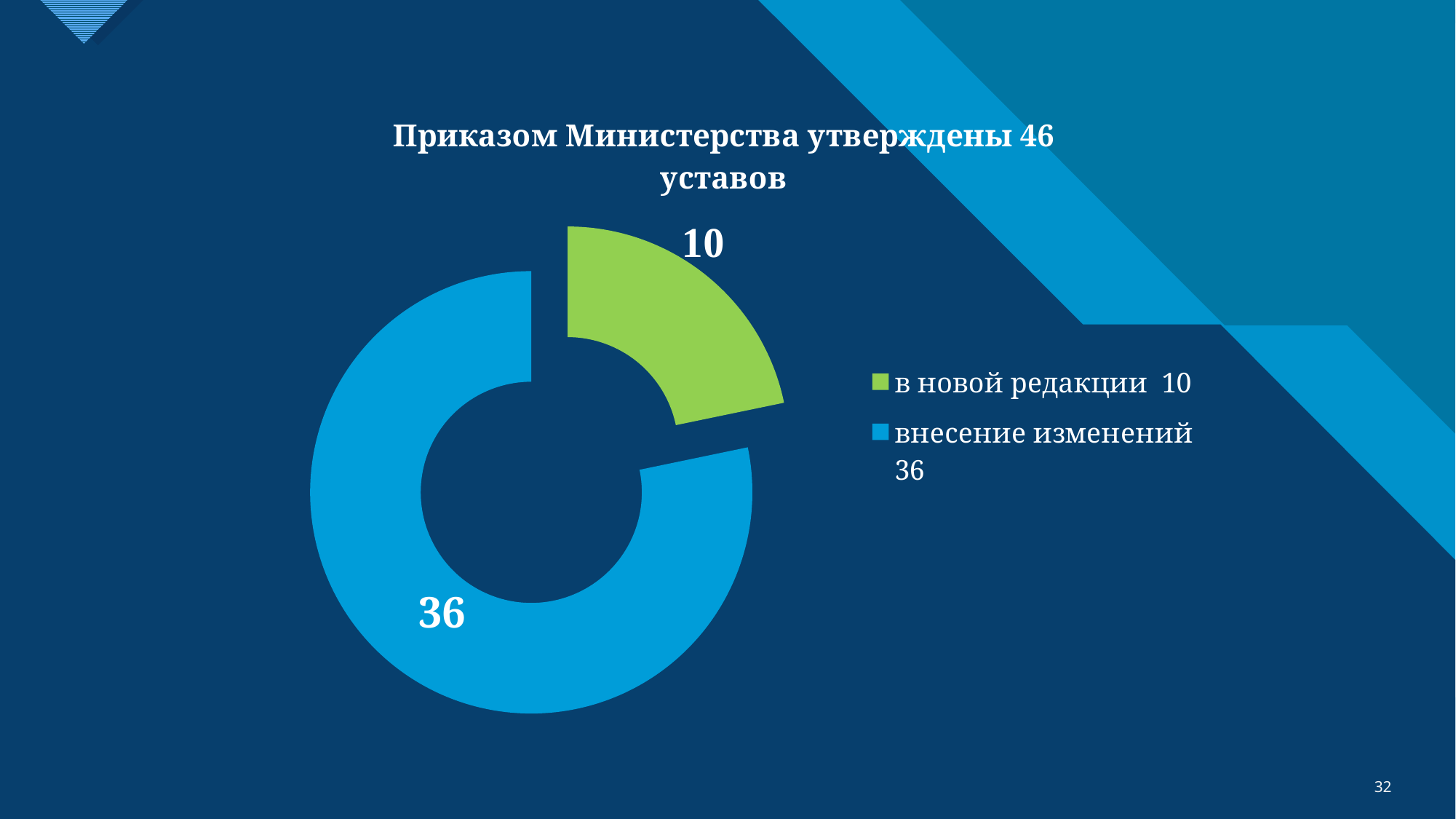
Which category has the largest slice in the chart? внесение изменений 36 What value is shown for the 'внесение изменений 36' slice? 36 What is the total of the two slices in the chart? 46 What colour is the 'в новой редакции' slice? Green What kind of chart is shown on the slide? Doughnut (pie) chart What value is shown for the 'в новой редакции 10' slice? 10 Which is larger: the 'в новой редакции' slice or the 'внесение изменений' slice? внесение изменений Which category has the smallest slice in the chart? в новой редакции 10 What is the title of the chart? Приказом Министерства утверждены 46 уставов How many slices does the chart have? 2 How many entries does the legend list? 2 What is the difference between the 'внесение изменений' value and the 'в новой редакции' value? 26